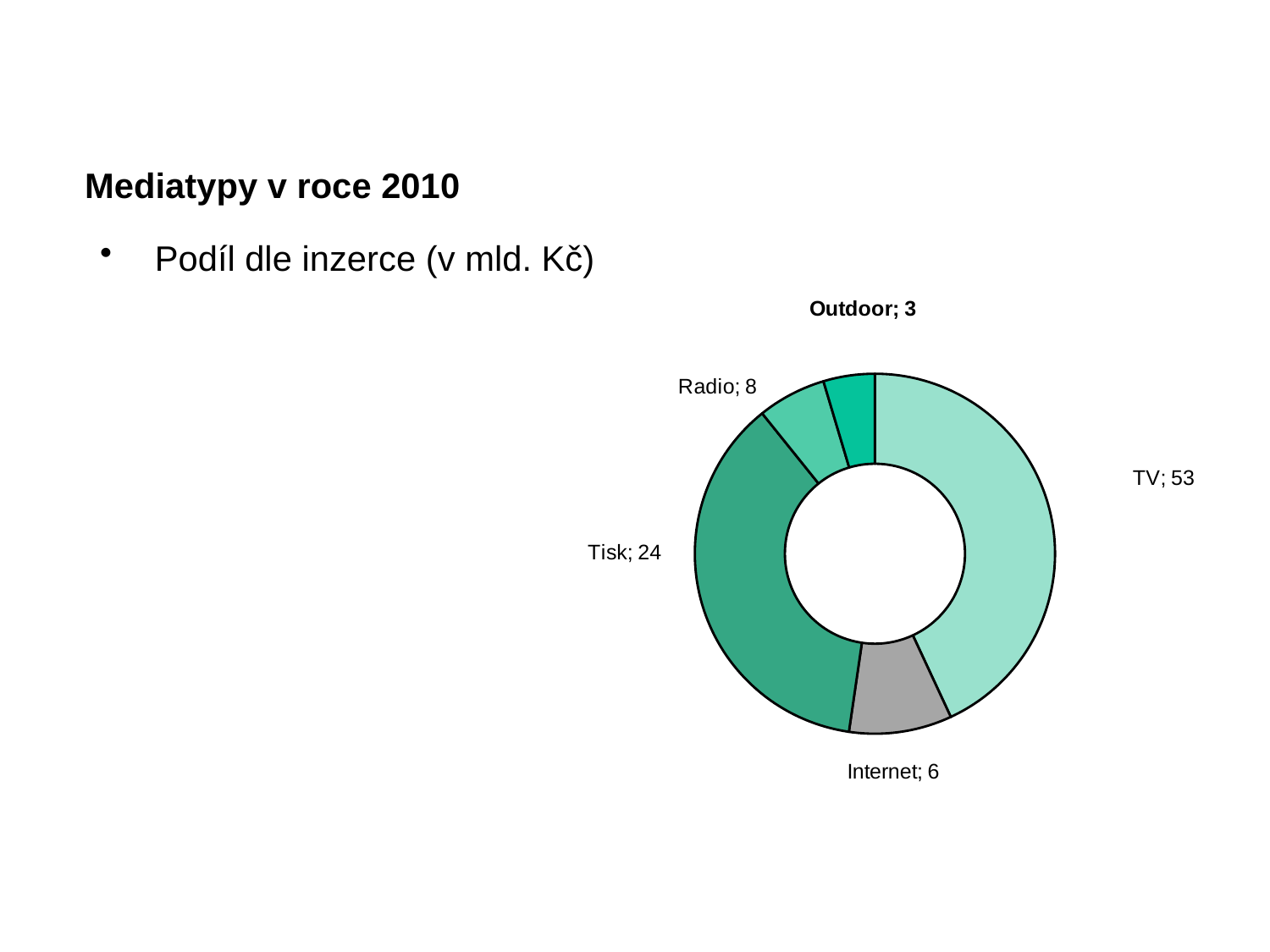
Which category has the lowest value in the chart? Outdoor What kind of chart is shown on the slide? Doughnut chart What is the total of all the values shown in the chart? 94 What is the value for TV in the doughnut chart? 53 What is the value for Tisk in the chart? 24 What is the value for Internet in the chart? 6 Which category has the highest value in the chart? TV What is the value for Outdoor in the chart? 3 What is the difference between the values for Radio and Internet? 2 Which is larger, the value for Radio or the value for Internet? Radio What is the difference between the values for TV and Tisk? 29 How many categories are shown in the chart? 5